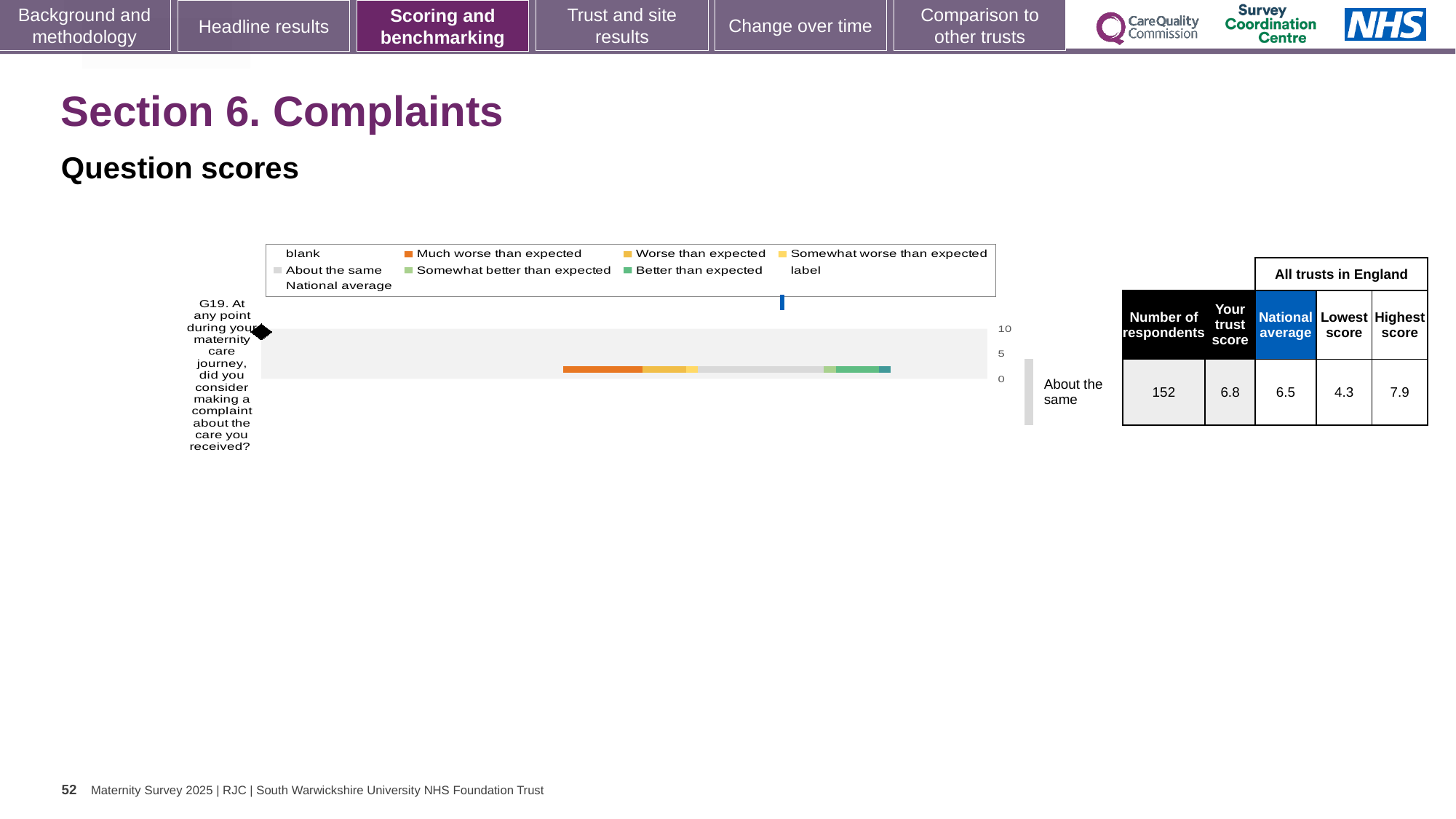
What is the highest score among all trusts in England for question G19? 7.9 What is the national average for question G19 shown in the table beside the chart? 6.5 What kind of chart is shown on the slide? bar chart How many respondents answered question G19 according to the table beside the chart? 152 Which is larger for question G19, the trust score or the national average? trust score What colour represents 'Much worse than expected' in the chart legend? orange Which benchmark category is shown for question G19 next to the chart? About the same How many survey questions are plotted in the chart? 1 What is the difference between the highest score and the lowest score for question G19? 3.6 What is the trust score for question G19 shown in the table beside the chart? 6.8 By how much does the trust score for question G19 exceed the national average? 0.3